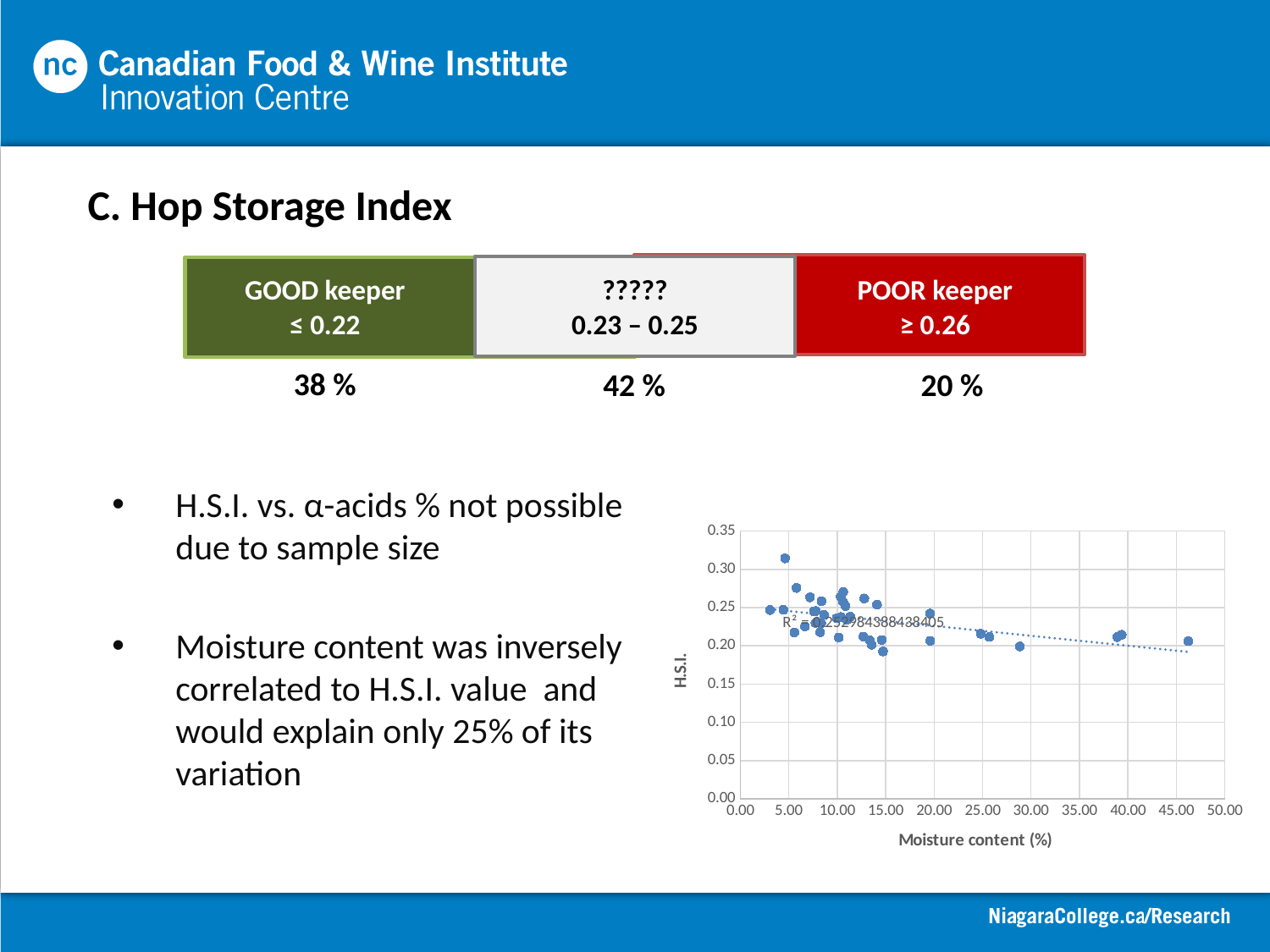
What kind of chart is shown on the slide? scatter chart What is the maximum value shown on the y axis of the scatter chart? 0.35 Do the H.S.I. values generally rise or fall as moisture content increases along the x axis? fall Is the highest H.S.I. value plotted on the scatter chart greater or less than 0.30? greater What is the title of the y axis of the scatter chart? H.S.I. Is the H.S.I. value of the point with the highest moisture content (around 46%) greater or less than 0.25? less Is the H.S.I. value of the point at about 29% moisture content greater or less than 0.25? less What is the title of the x axis of the scatter chart? Moisture content (%)